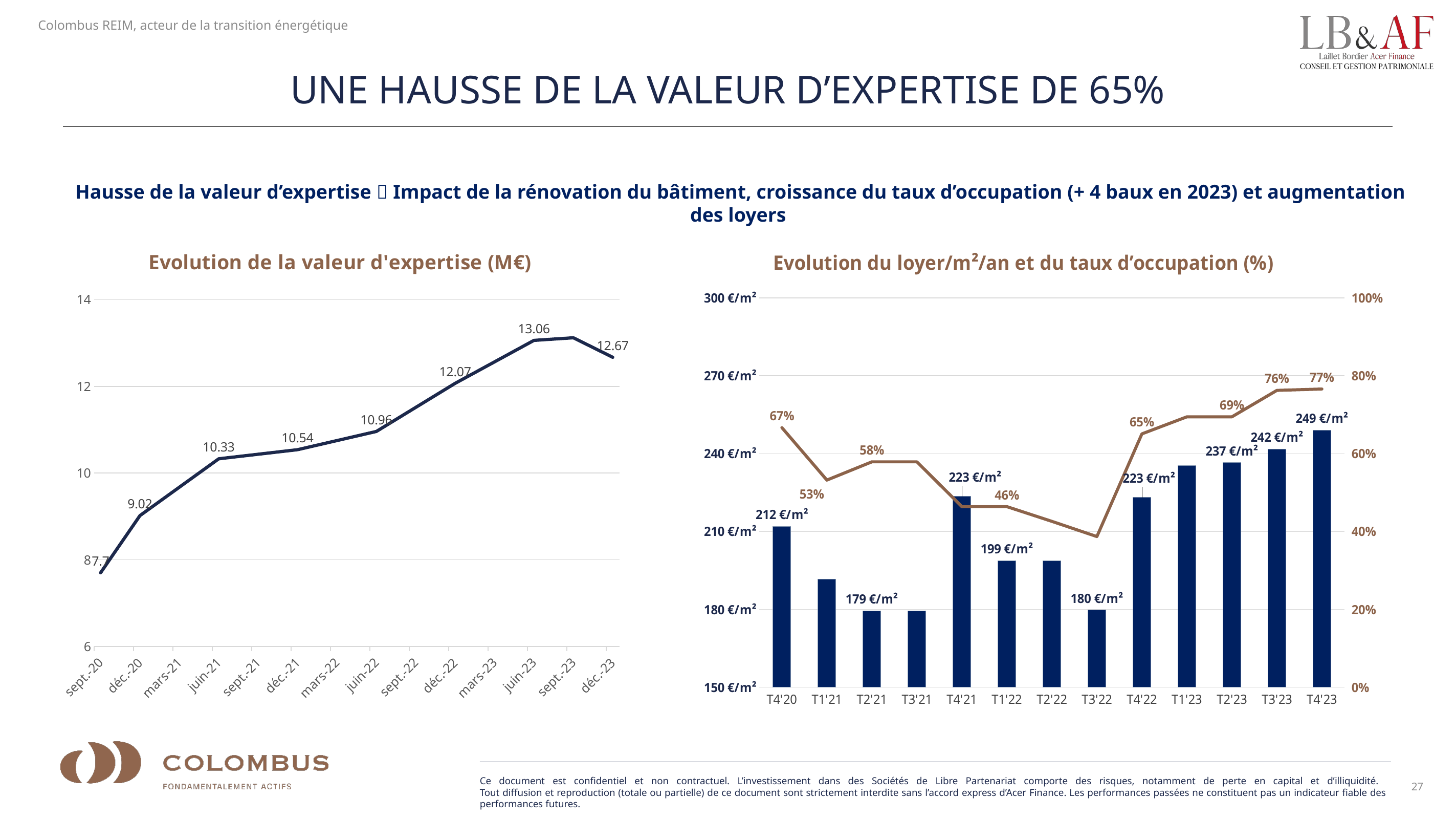
In the right-hand chart, what is the difference between the rent for T4'23 and the rent for T4'20? 37 €/m² In the chart 'Evolution de la valeur d'expertise (M€)', what is the value for déc.-23? 12.67 In the chart 'Evolution de la valeur d'expertise (M€)', what is the value for juin-23? 13.06 In the chart 'Evolution de la valeur d'expertise (M€)', do the values generally rise or fall from sept.-20 to juin-23? Rise In the right-hand chart, which quarter has the lowest occupancy rate? T3'22 In the right-hand chart, is the rent bar for T1'21 greater or less than 210 €/m²? less In the chart 'Evolution de la valeur d'expertise (M€)', what is the difference between the juin-23 value and the déc.-23 value? 0.39 In the right-hand chart 'Evolution du loyer/m²/an et du taux d'occupation (%)', what is the rent value for T4'23? 249 €/m² In the right-hand chart, what is the occupancy rate for T4'23? 77% How many data points are plotted in the chart 'Evolution de la valeur d'expertise (M€)'? 9 In the right-hand chart, which quarter has the highest rent per m²? T4'23 What kind of chart is 'Evolution de la valeur d'expertise (M€)'? Line chart